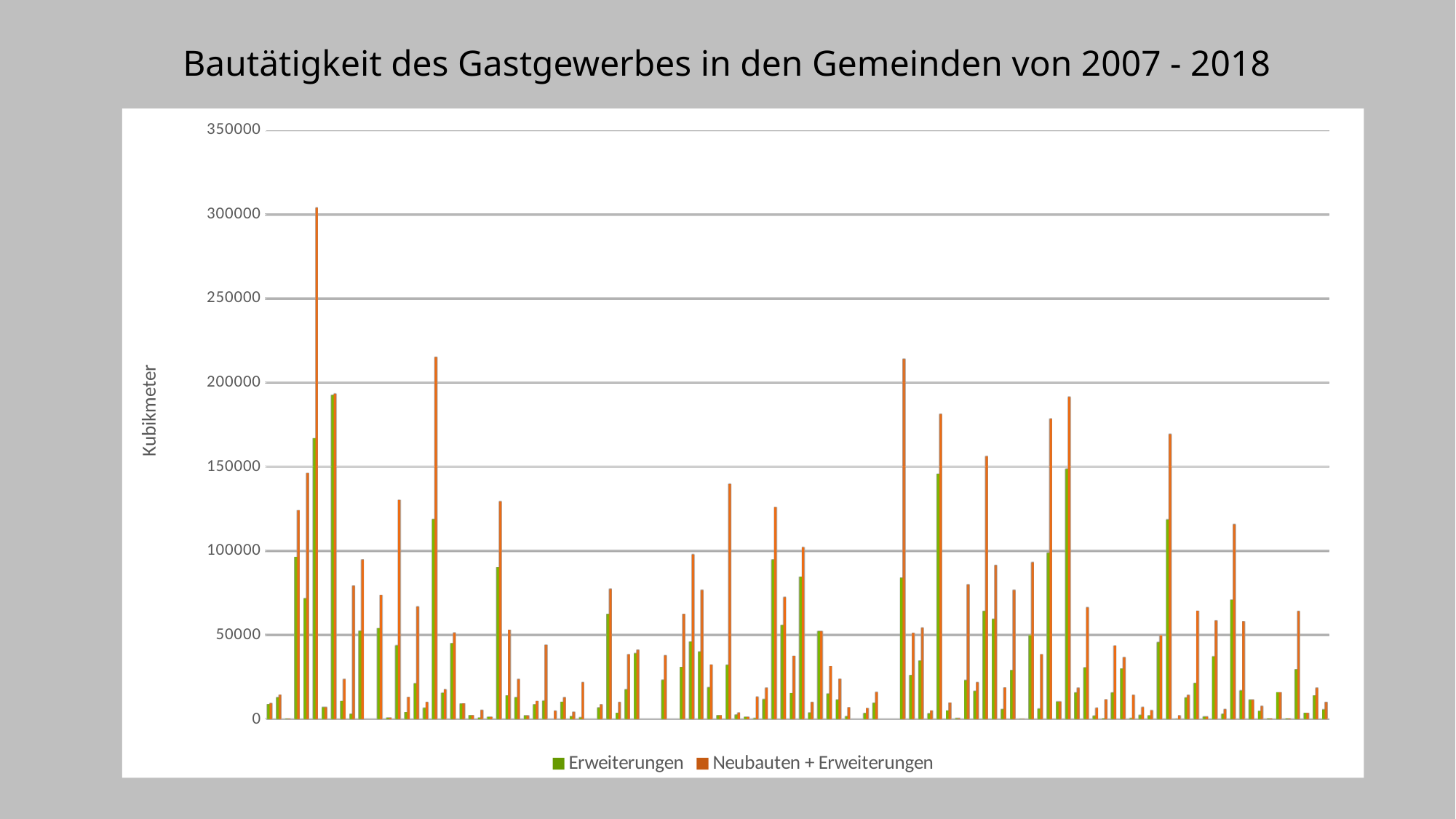
What kind of chart is shown on the slide? bar chart What is the label of the vertical axis? Kubikmeter How many series does the legend list? 2 What are the two series named in the legend? Erweiterungen; Neubauten + Erweiterungen What is the highest value shown on the vertical axis? 350000 What is the title of the chart? Bautätigkeit des Gastgewerbes in den Gemeinden von 2007 - 2018 Is the tallest bar of the Erweiterungen series greater or less than 200000? less Which series has the tallest bar on the chart, Erweiterungen or Neubauten + Erweiterungen? Neubauten + Erweiterungen Is the tallest bar of the Neubauten + Erweiterungen series greater or less than 250000? greater